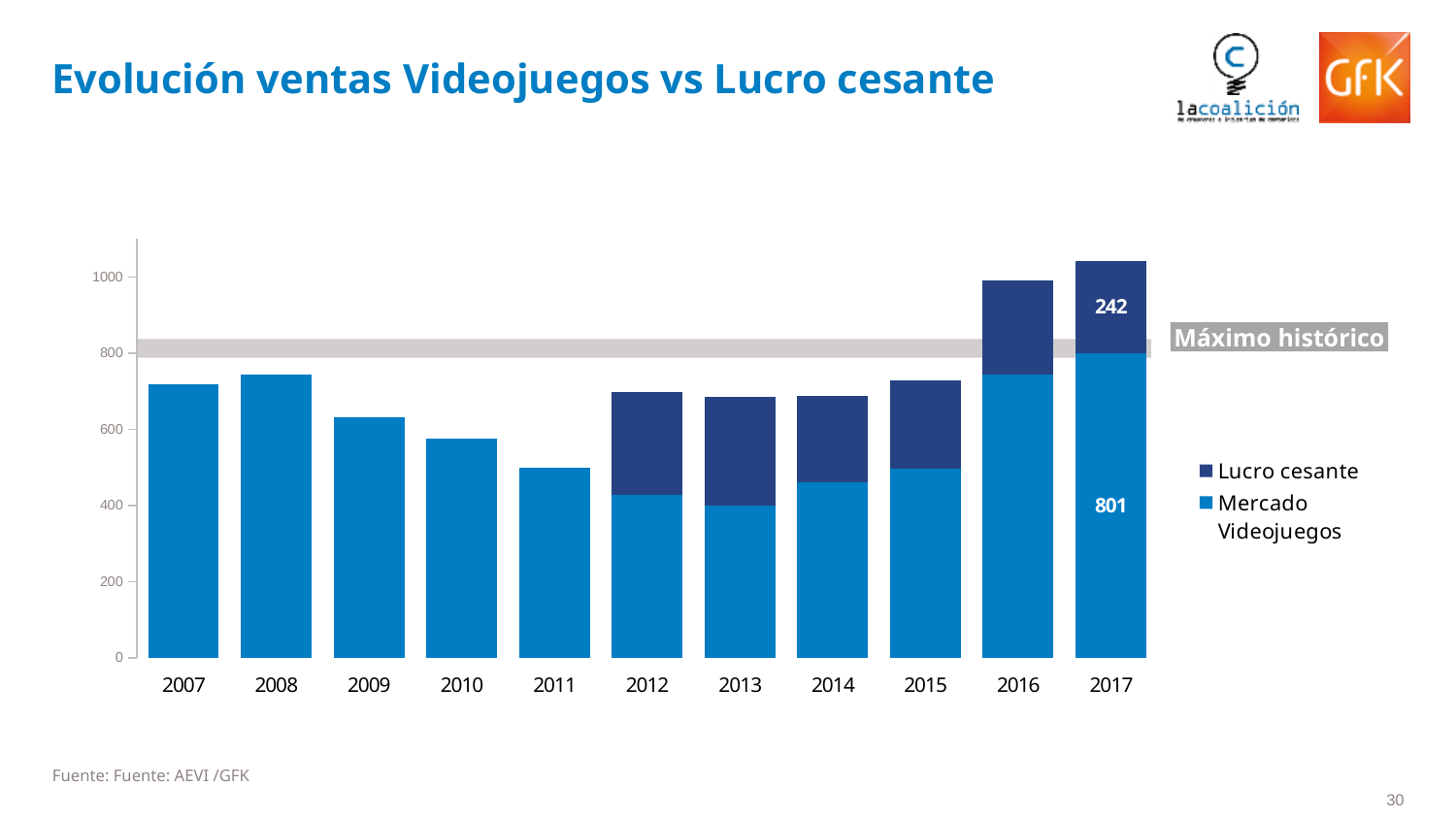
What is the total of the stacked bar for 2017? 1043 Does the Mercado Videojuegos value rise or fall from 2008 to 2011? fall Is the total stacked bar for 2016 greater or less than 800? greater Which year has the shortest bar overall? 2011 What kind of chart is shown on the slide? Stacked bar chart How many series does the legend list? 2 What is the value of Mercado Videojuegos for 2017? 801 How many years are shown on the x axis? 11 What is the value of Lucro cesante for 2017? 242 Is the value for Mercado Videojuegos in 2011 greater or less than 600? less Which year has the tallest stacked bar overall? 2017 In 2017, which is larger: Mercado Videojuegos or Lucro cesante? Mercado Videojuegos